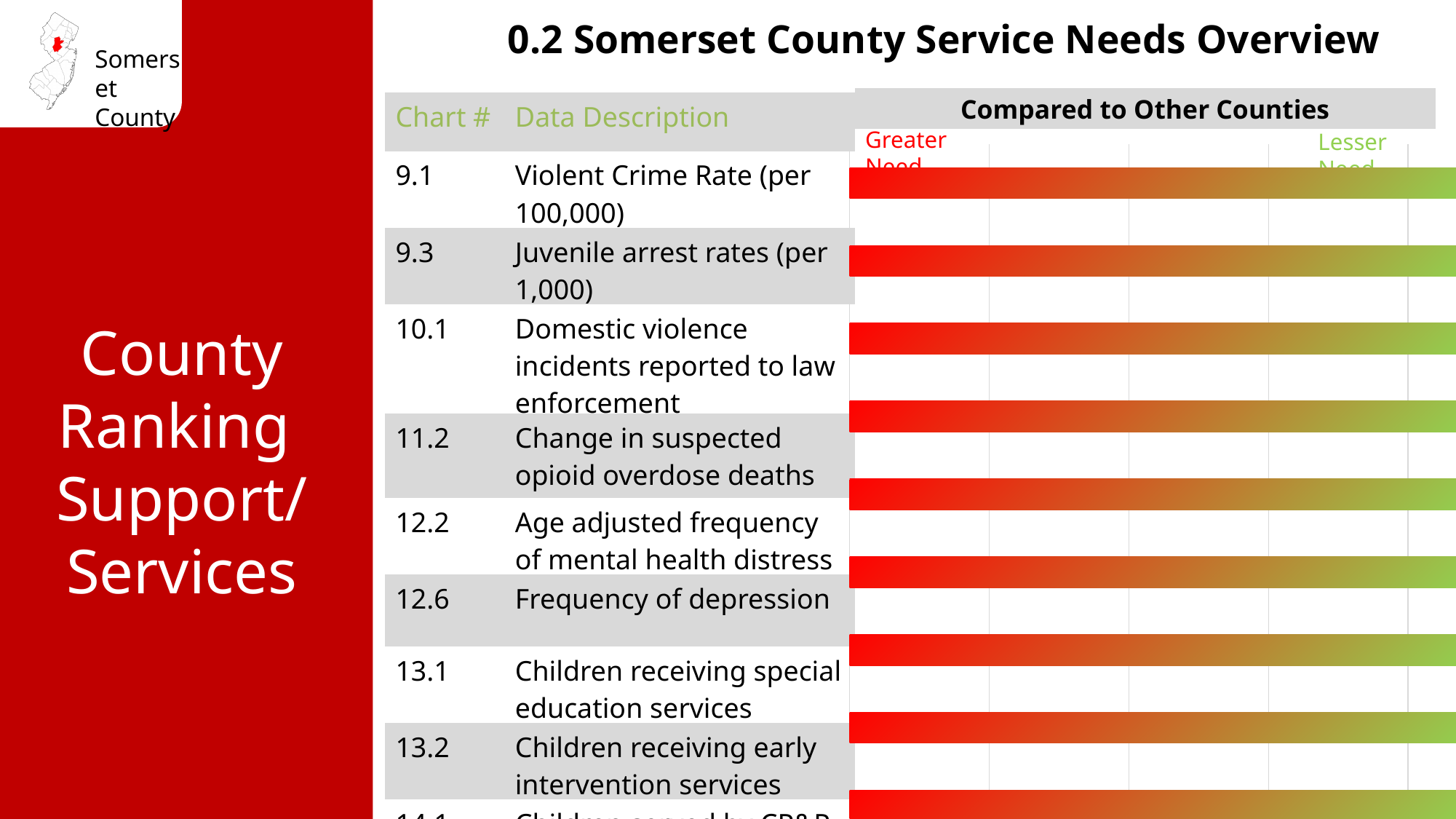
What data description is listed for chart number 12.6? Frequency of depression How many chart numbers (e.g. 9.1, 9.3) are fully readable in the 'Chart #' column of the table? 8 What is the heading printed above the bars on the right side of the slide? Compared to Other Counties What kind of chart is shown under the heading 'Compared to Other Counties'? bar chart Which end of the bars is labelled 'Greater Need', the left or the right? left What chart number is listed for 'Juvenile arrest rates (per 1,000)'? 9.3